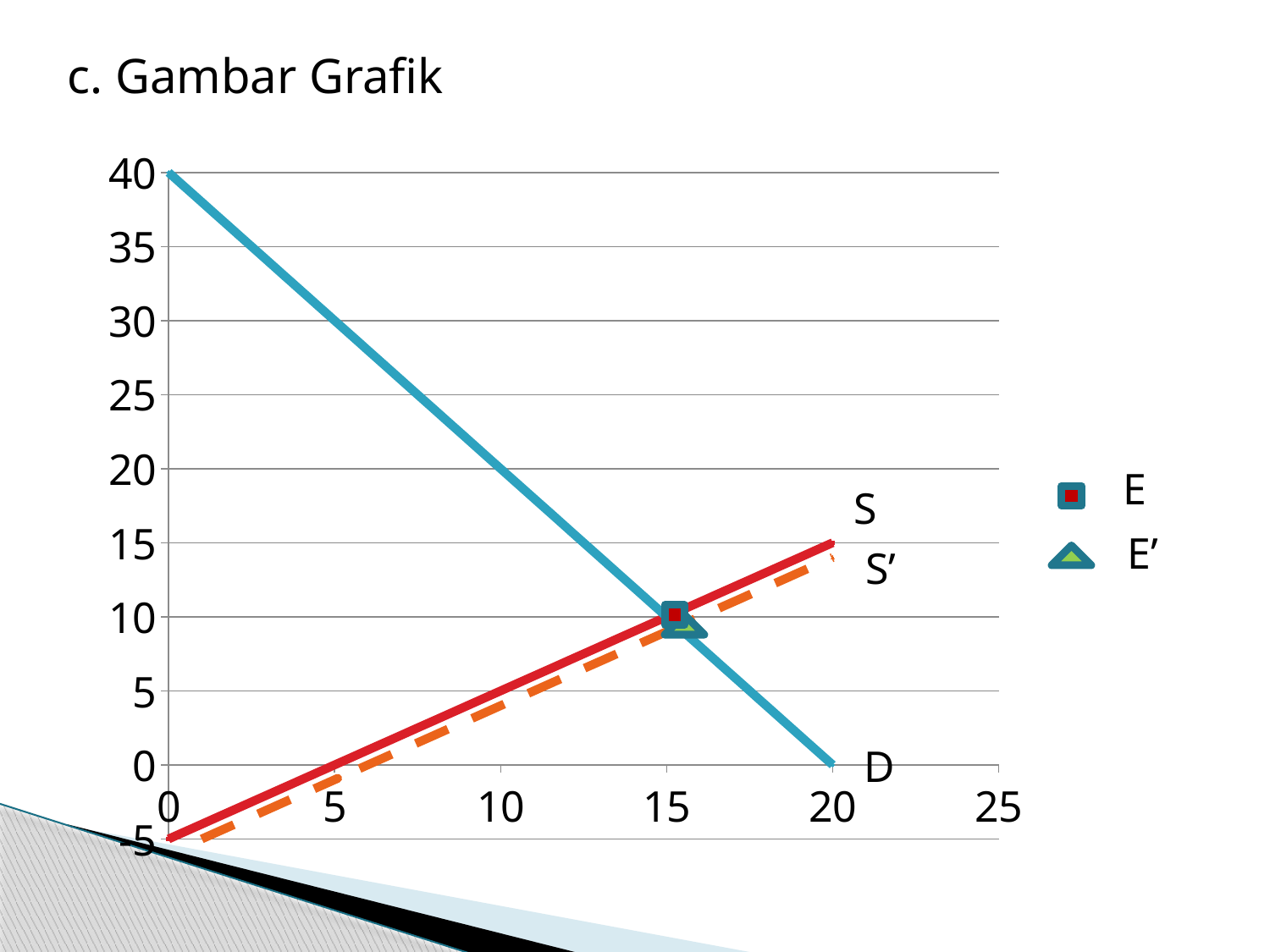
How many entries does the chart legend list? 2 At x = 5, which line has the higher y value, D or S? D Does the line labelled S rise or fall as the x value increases? rise What kind of chart is shown on the slide? line chart Does the line labelled D rise or fall as the x value increases? fall What is the y value of the line labelled S at x = 20? 15 What is the title of the slide? c. Gambar Grafik What is the y value of the line labelled D at x = 0? 40 What is the y value of the line labelled S at x = 0? -5 What are the two entries in the chart legend? E and E' Is the y value of the line labelled D at x = 10 greater or less than 15? greater At what x value does the line labelled D reach a y value of 0? 20